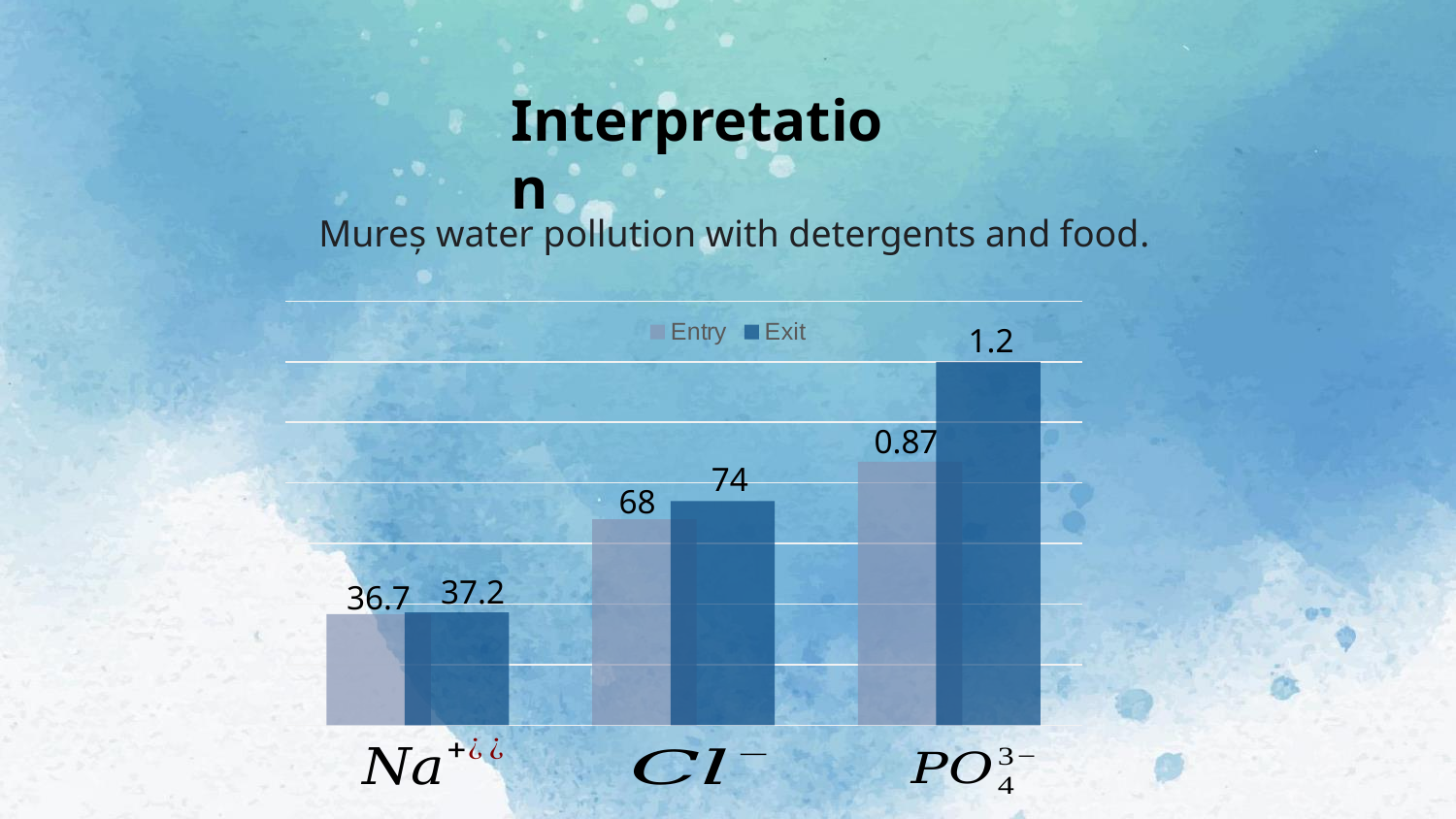
What is the Exit value for PO₄³⁻? 1.2 What is the Entry value for Cl⁻? 68 How many series does the legend list? 2 What is the difference between the Exit and Entry values for Na⁺? 0.5 What is the Entry value for PO₄³⁻? 0.87 What is the Entry value for Na⁺? 36.7 How many categories are shown on the x axis of the chart? 3 What kind of chart is shown on the slide? Bar chart For Na⁺, which series has the larger value, Entry or Exit? Exit What is the difference between the Exit and Entry values for Cl⁻? 6 For PO₄³⁻, which series has the larger value, Entry or Exit? Exit What is the Exit value for Cl⁻? 74